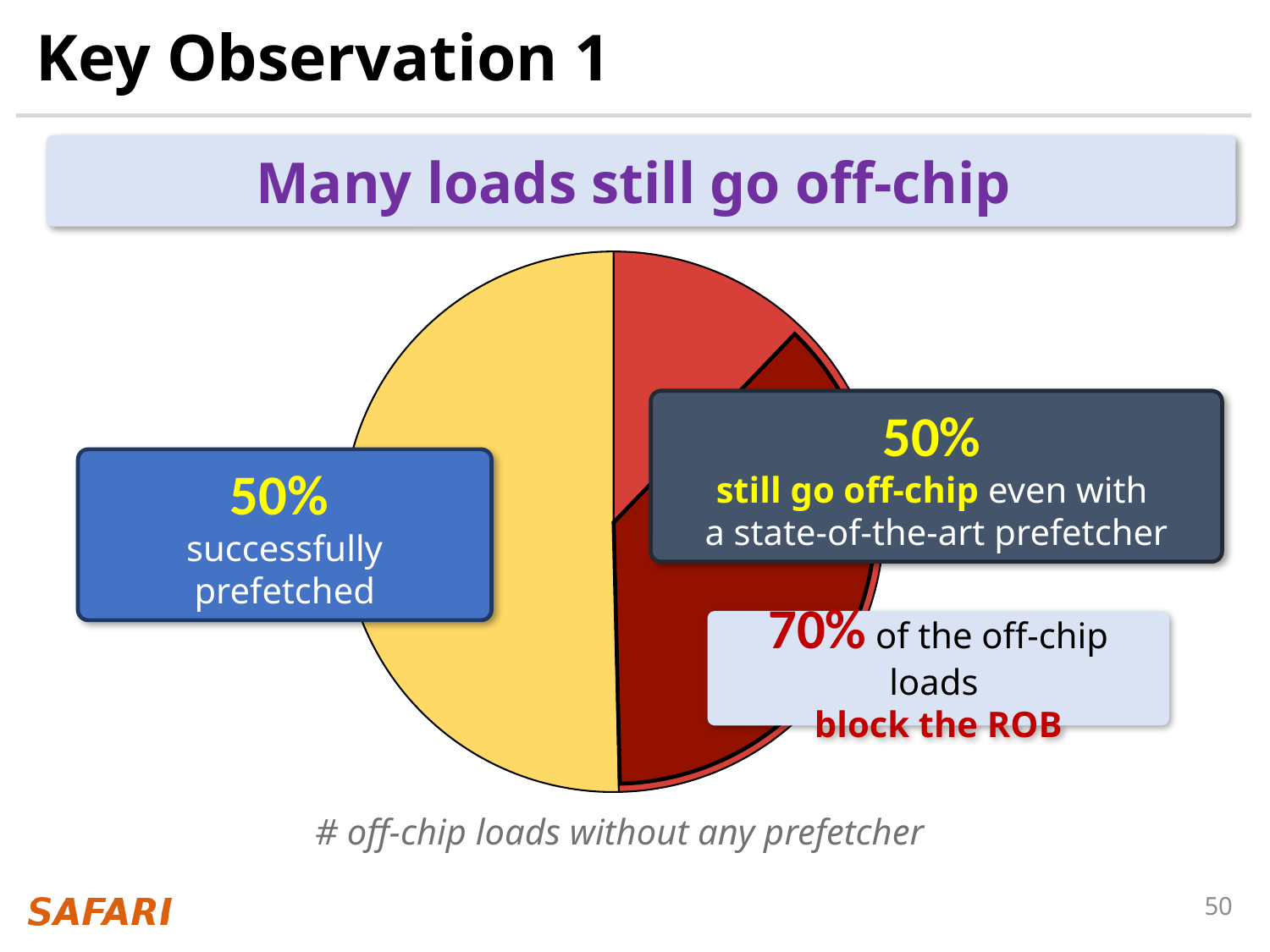
What share of off-chip loads is successfully prefetched according to the pie chart? 50% Is the share of loads that still go off-chip larger or smaller than the share successfully prefetched? equal What is the difference between the share of off-chip loads that block the ROB and the share of loads successfully prefetched? 20% Is the share of off-chip loads that block the ROB greater or less than 50%? greater What share of loads still go off-chip even with a state-of-the-art prefetcher? 50% What does the caption below the pie chart say the chart represents? # off-chip loads without any prefetcher What is the total of the successfully prefetched share and the still-go-off-chip share? 100% What kind of chart is shown on the slide? pie chart What percentage of the off-chip loads block the ROB? 70% Which colour represents the loads that are successfully prefetched in the pie chart? yellow